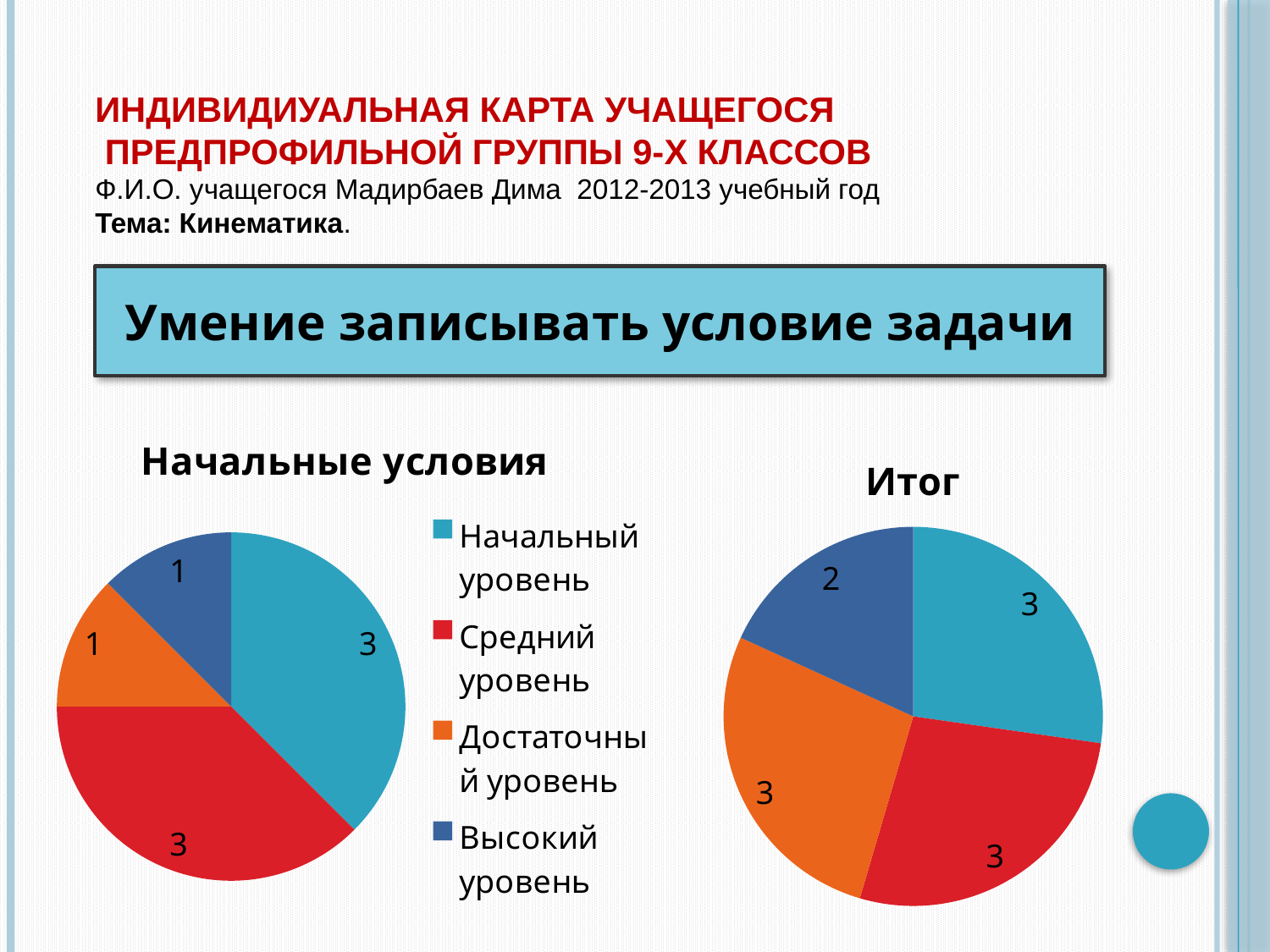
In the 'Итог' chart, what is the difference between the values for Начальный уровень and Высокий уровень? 1 How many slices does the 'Итог' chart have? 4 In the 'Начальные условия' chart, which is larger: the value for Средний уровень or the value for Достаточный уровень? Средний уровень What type of chart is 'Начальные условия'? Pie chart In the 'Итог' chart, which category has the lowest value? Высокий уровень In the 'Начальные условия' chart, what is the value for Достаточный уровень? 1 In the 'Начальные условия' chart, what share of the total does Высокий уровень represent? 12.5% In the 'Итог' chart, what is the value for Достаточный уровень? 3 In the 'Итог' chart, what is the value for Высокий уровень? 2 In the 'Начальные условия' chart, what is the value for Начальный уровень? 3 In the 'Начальные условия' chart, what is the difference between the values for Средний уровень and Высокий уровень? 2 How many entries does the legend list? 4